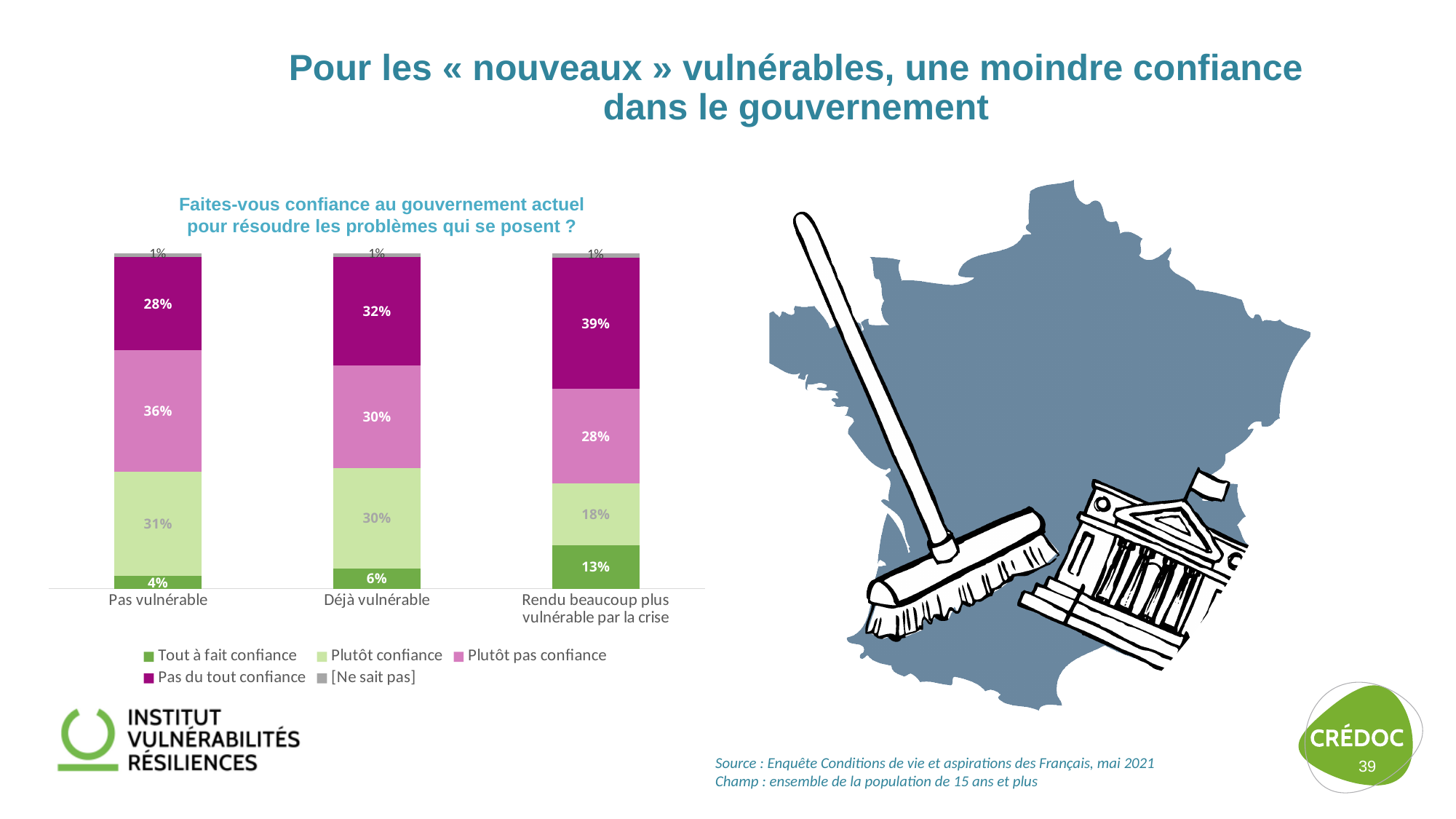
What is the title of the chart? Faites-vous confiance au gouvernement actuel pour résoudre les problèmes qui se posent ? What is the value of 'Pas du tout confiance' for 'Rendu beaucoup plus vulnérable par la crise'? 39% What is the value of 'Plutôt confiance' for 'Rendu beaucoup plus vulnérable par la crise'? 18% Which category has the lowest value for 'Tout à fait confiance'? Pas vulnérable Which is larger: 'Plutôt confiance' for 'Pas vulnérable' or 'Plutôt confiance' for 'Rendu beaucoup plus vulnérable par la crise'? Pas vulnérable What is the value of 'Plutôt pas confiance' for 'Déjà vulnérable'? 30% What is the difference between the 'Pas du tout confiance' values for 'Rendu beaucoup plus vulnérable par la crise' and 'Pas vulnérable'? 11% How many series does the chart legend list? 5 What type of chart is shown on the slide? Stacked bar chart What is the value of 'Tout à fait confiance' for 'Pas vulnérable'? 4% Which category has the highest value for 'Pas du tout confiance'? Rendu beaucoup plus vulnérable par la crise How many categories are shown on the x axis of the chart? 3